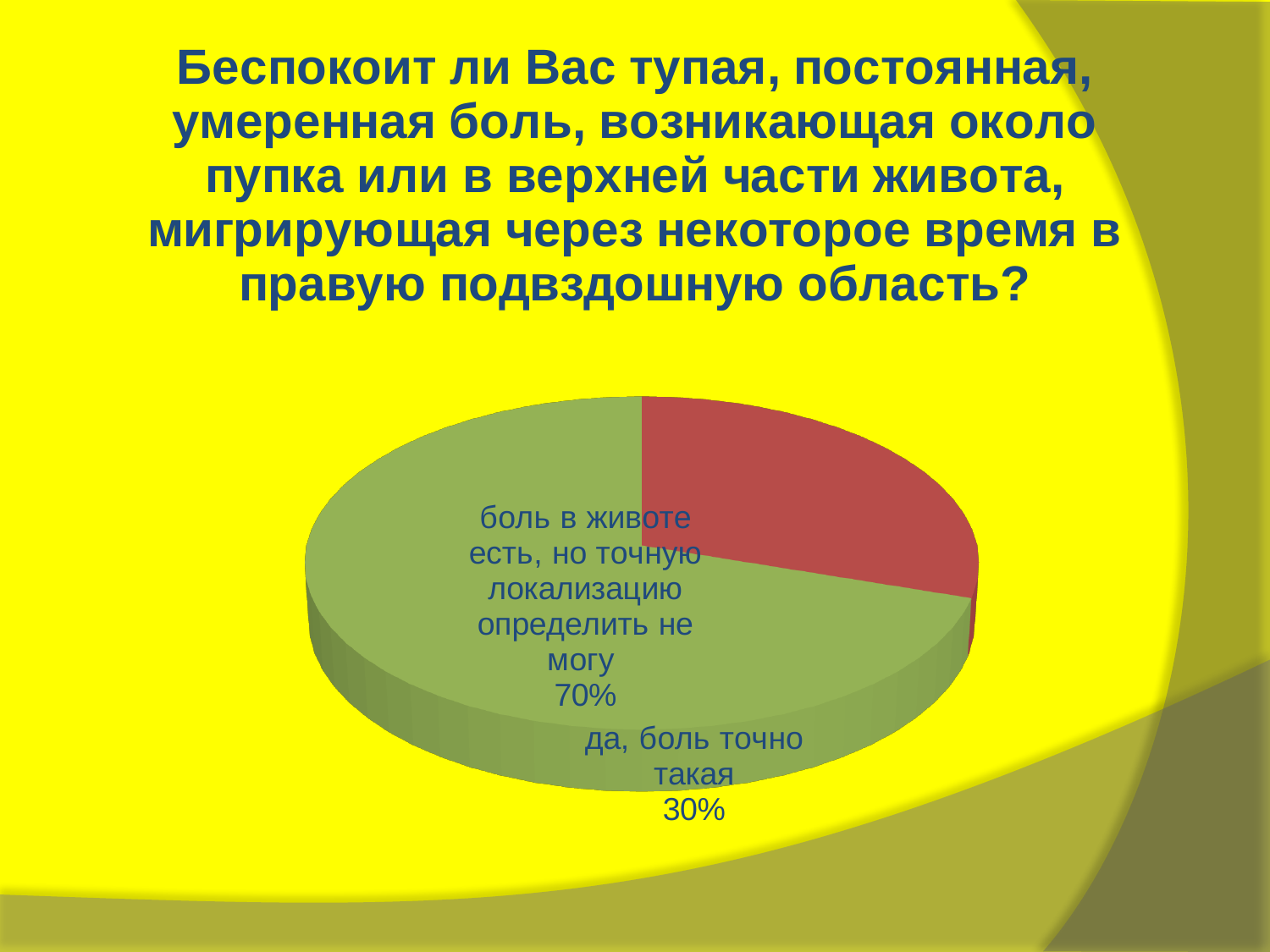
What colour is the slice labelled "да, боль точно такая"? red Which slice of the pie is the largest? боль в животе есть, но точную локализацию определить не могу What kind of chart is shown on the slide? pie chart Is the share for "да, боль точно такая" greater or less than 50%? less What share of the pie is labelled "да, боль точно такая"? 30% Which is larger: the slice for "да, боль точно такая" or the slice for "боль в животе есть, но точную локализацию определить не могу"? боль в животе есть, но точную локализацию определить не могу What colour is the slice labelled "боль в животе есть, но точную локализацию определить не могу"? green What share of the pie is labelled "боль в животе есть, но точную локализацию определить не могу"? 70% How many slices does the pie chart have? 2 Which slice of the pie is the smallest? да, боль точно такая What is the difference in percentage points between the two slices of the pie? 40%